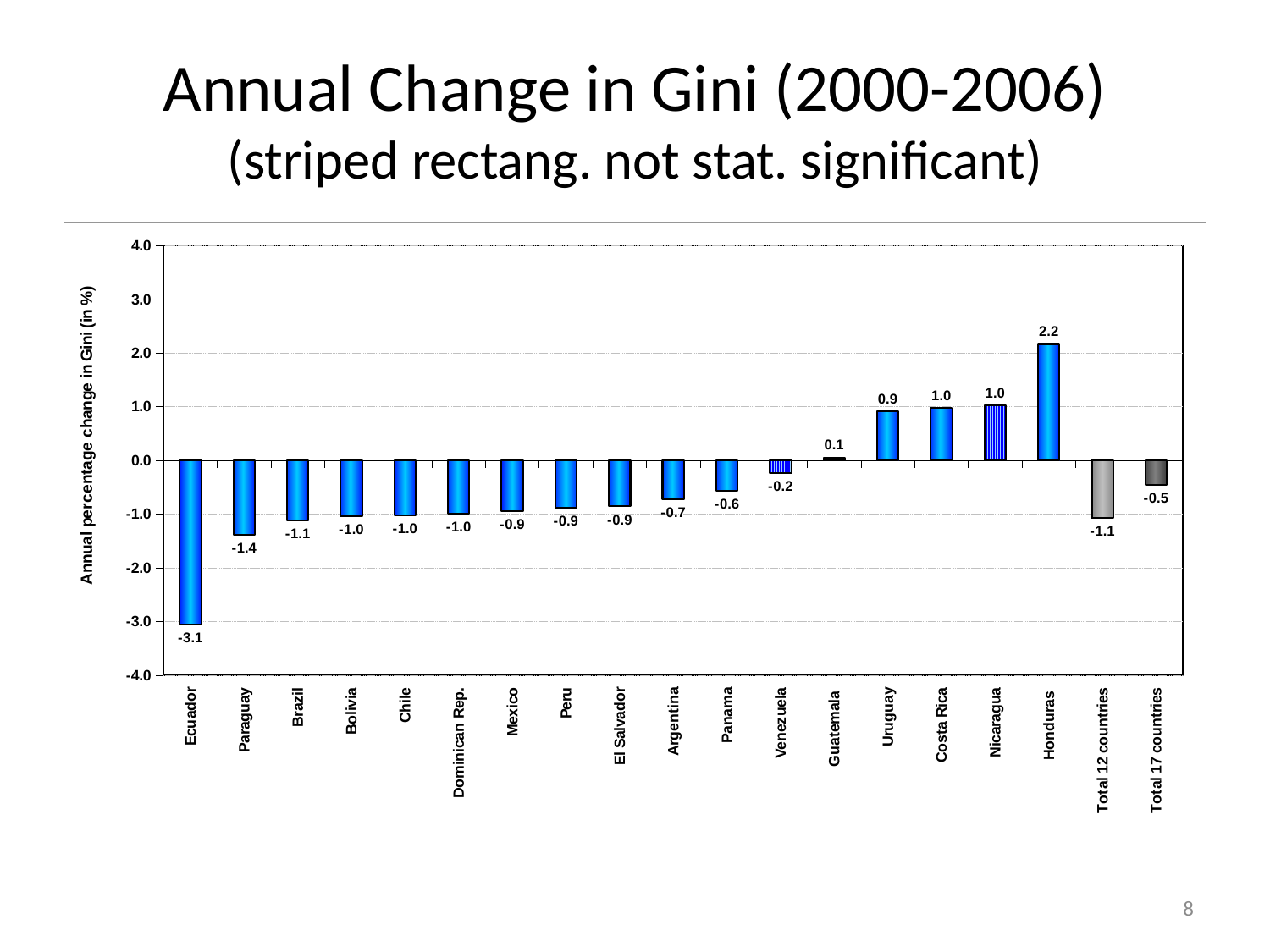
Which has a larger annual change in Gini, Argentina or Panama? Panama Which countries are shown with striped bars (not statistically significant)? Venezuela, Guatemala and Nicaragua How many bars are shown in the chart? 19 What is the difference between the values for Honduras and Uruguay? 1.3 Which category has the highest annual change in Gini? Honduras What type of chart is shown on the slide? Bar chart Which category has the lowest annual change in Gini? Ecuador What is the annual change in Gini for Ecuador? -3.1 What is the label of the vertical axis? Annual percentage change in Gini (in %) What is the value shown for Paraguay? -1.4 What is the annual change in Gini for Honduras? 2.2 What is the value shown for Total 17 countries? -0.5